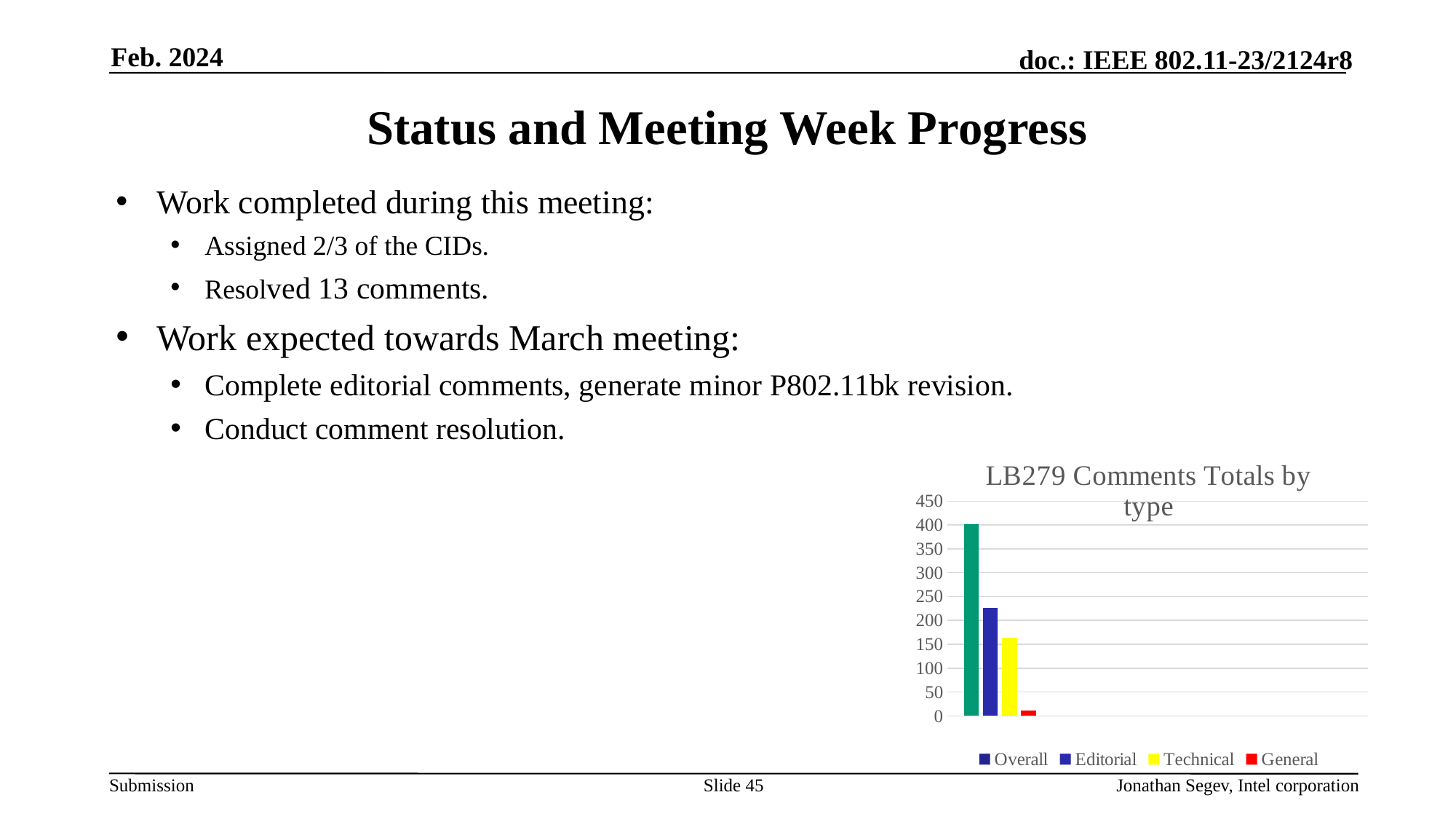
What colour is the General bar in the chart? red Is the value for General greater or less than 50? less Which series has the lowest value in the chart? General Is the value for Editorial greater or less than 200? greater How many series does the chart legend list? 4 Which is larger, the value for Editorial or the value for Technical? Editorial What kind of chart is shown on the slide? bar chart Is the value for Editorial greater or less than 250? less Which series has the highest value in the chart? Overall What is the title of the chart? LB279 Comments Totals by type